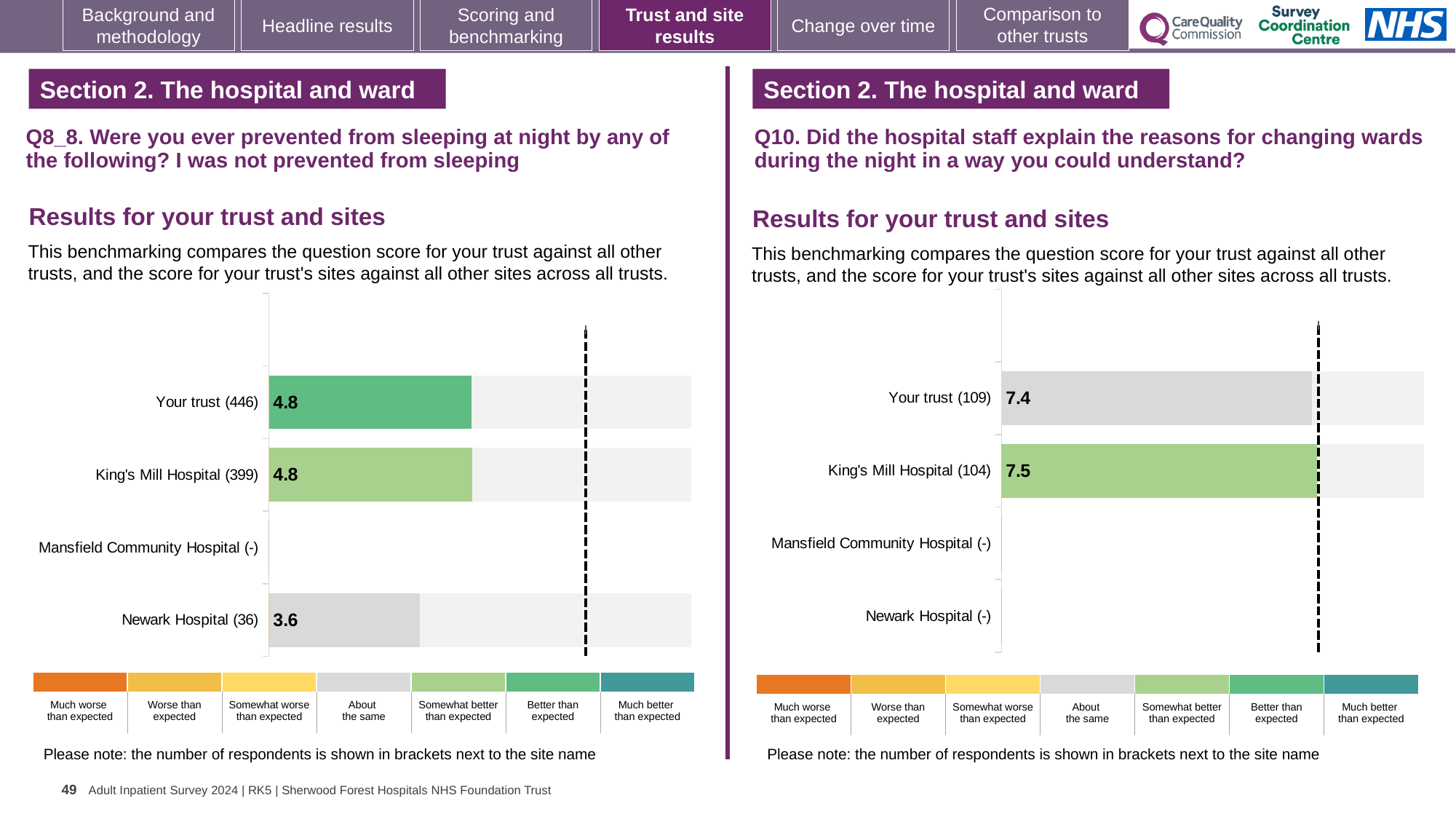
What kind of chart is used in the Q8_8 chart on the left? Bar chart In the Q8_8 chart on the left, what is the score for Newark Hospital? 3.6 In the Q8_8 chart on the left, what is the score for Your trust? 4.8 In the Q8_8 chart on the left, how many respondents are shown for Newark Hospital? 36 In the Q10 chart on the right, what is the score for King's Mill Hospital? 7.5 In the Q8_8 chart on the left, what is the difference between the scores for Your trust and Newark Hospital? 1.2 In the Q8_8 chart on the left, which site has the lowest score? Newark Hospital In the Q10 chart on the right, what is the score for Your trust? 7.4 In the Q10 chart on the right, how many respondents are shown for Your trust? 109 In the Q10 chart on the right, what is the difference between the scores for King's Mill Hospital and Your trust? 0.1 In the Q8_8 chart on the left, what is the score for King's Mill Hospital? 4.8 How many site/trust categories are listed on the y axis of the Q10 chart on the right? 4